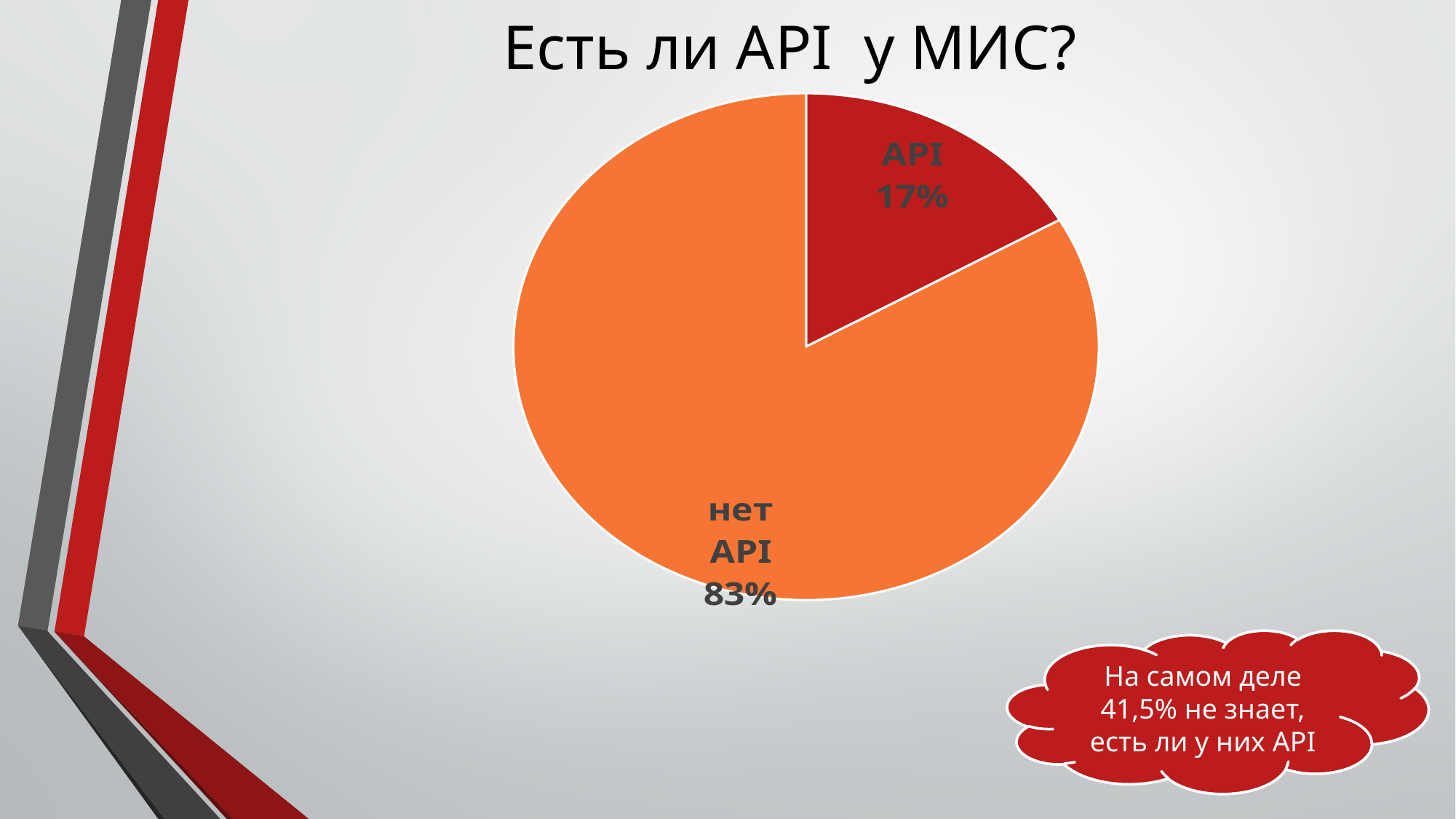
Which slice is the largest? нет API Which slice is the smallest? API Which is larger, the "API" slice or the "нет API" slice? нет API What share of the pie does the "нет API" slice represent? 83% What is the total of the two slice percentages shown? 100% What is the difference in percentage points between the "нет API" slice and the "API" slice? 66 What colour is the "API" slice? dark red What is the title of the chart? Есть ли API у МИС? What kind of chart is shown on the slide? pie chart What share of the pie does the "API" slice represent? 17% How many slices does the pie chart have? 2